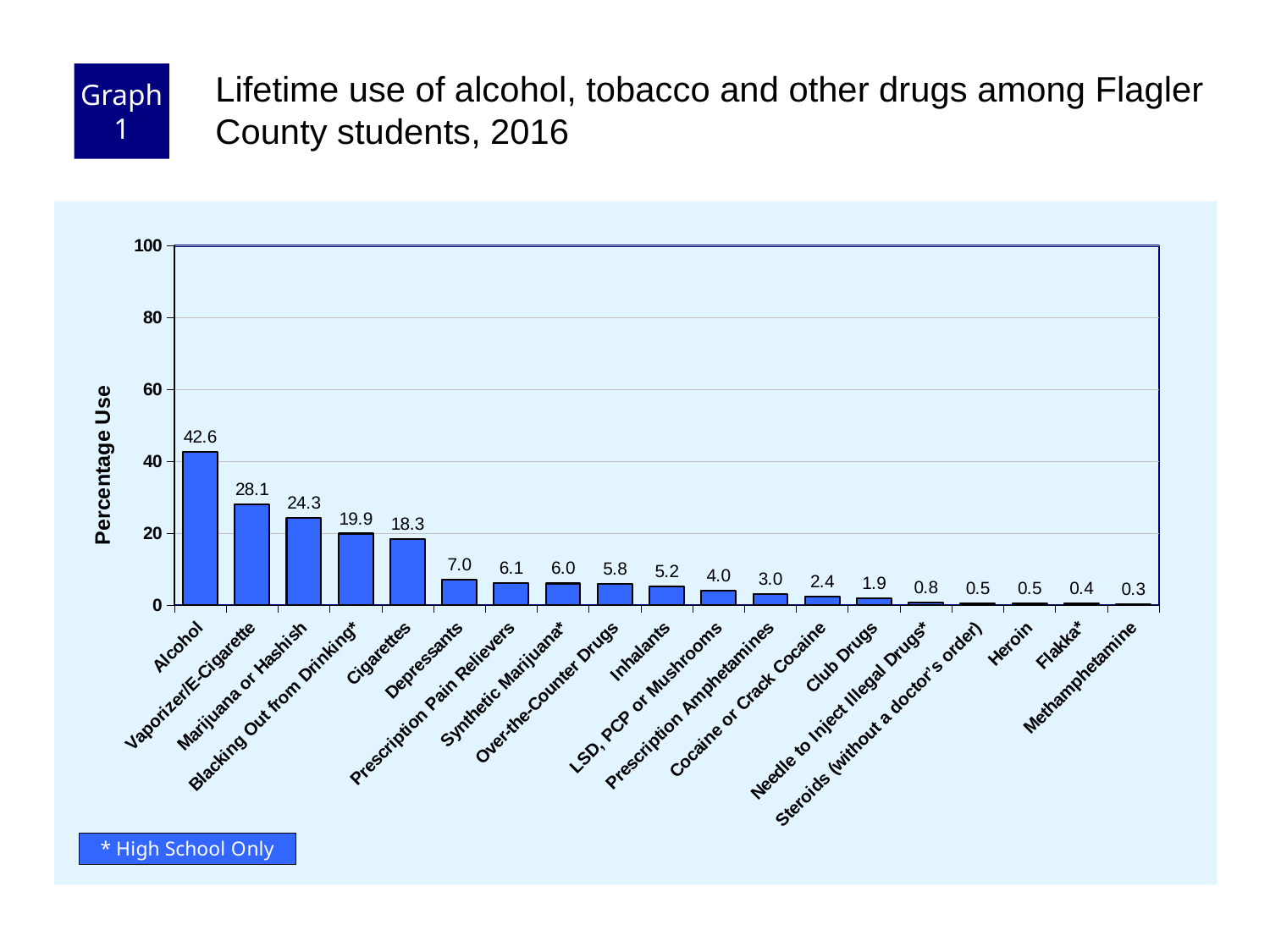
Which category has the highest lifetime use percentage? Alcohol How many categories are shown on the x axis? 19 What is the difference between the values for Alcohol and Vaporizer/E-Cigarette? 14.5 What kind of chart is shown on the slide? Bar chart What is the lifetime use percentage for Alcohol? 42.6 What is the value shown for Inhalants? 5.2 Is the value for Blacking Out from Drinking* greater or less than 20? less What is the difference between the values for Marijuana or Hashish and Cigarettes? 6.0 What is the value shown for Vaporizer/E-Cigarette? 28.1 Which is larger, the value for Depressants or the value for Club Drugs? Depressants What is the value shown for Cigarettes? 18.3 Which category has the lowest lifetime use percentage? Methamphetamine